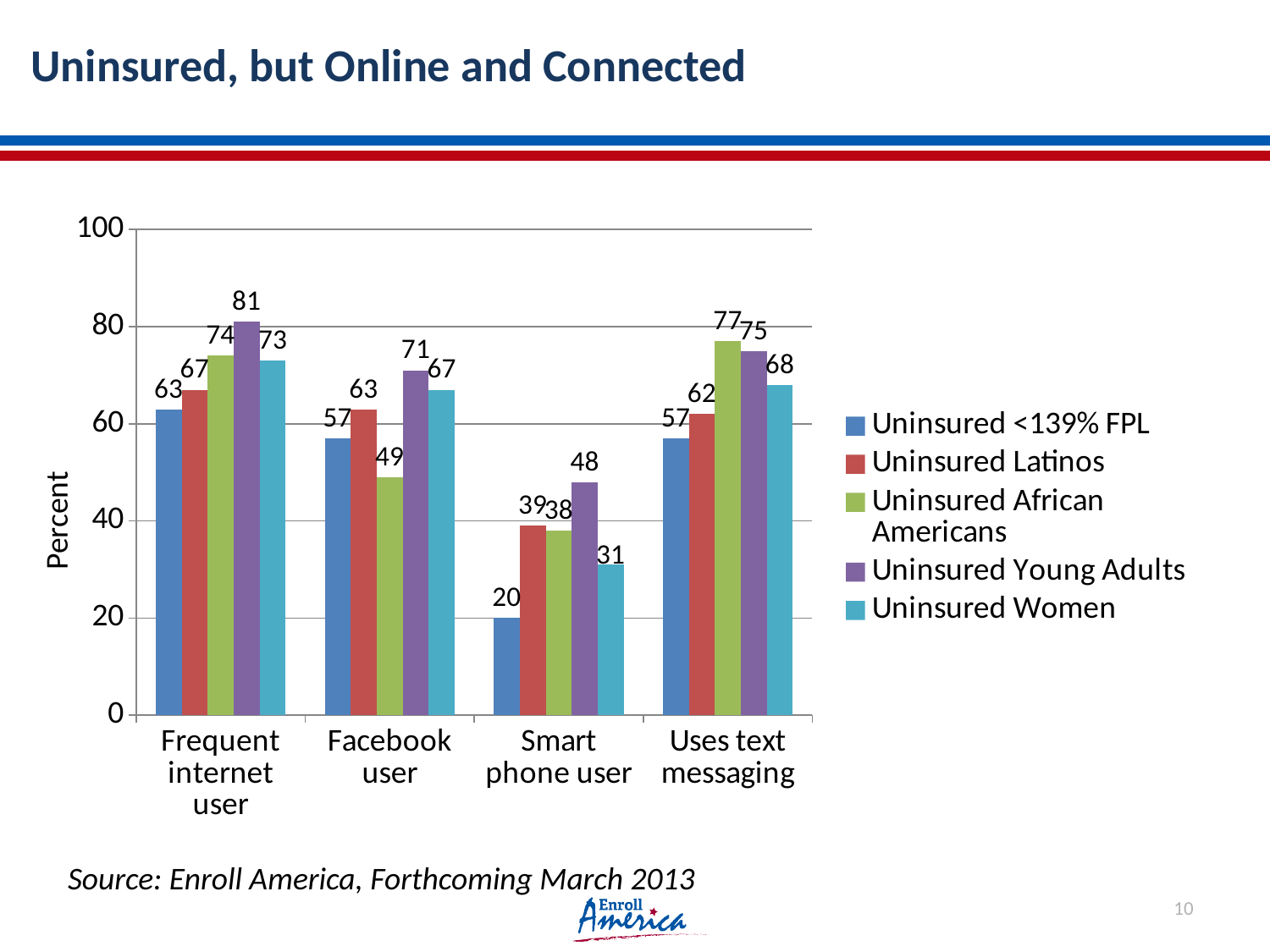
What is the value for Uninsured Young Adults in the Frequent internet user category? 81 What is the value for Uninsured Women in the Facebook user category? 67 How many series does the legend list? 5 Which is larger in the Facebook user category: Uninsured Latinos or Uninsured African Americans? Uninsured Latinos How many categories are shown on the x axis? 4 What kind of chart is shown on the slide? Bar chart Which series has the lowest value in the Smart phone user category? Uninsured <139% FPL What is the value for Uninsured African Americans in the Uses text messaging category? 77 What is the difference between Uninsured Young Adults and Uninsured Women in the Smart phone user category? 17 Which series has the highest value in the Facebook user category? Uninsured Young Adults What is the value for Uninsured <139% FPL in the Smart phone user category? 20 What is the label of the y axis? Percent